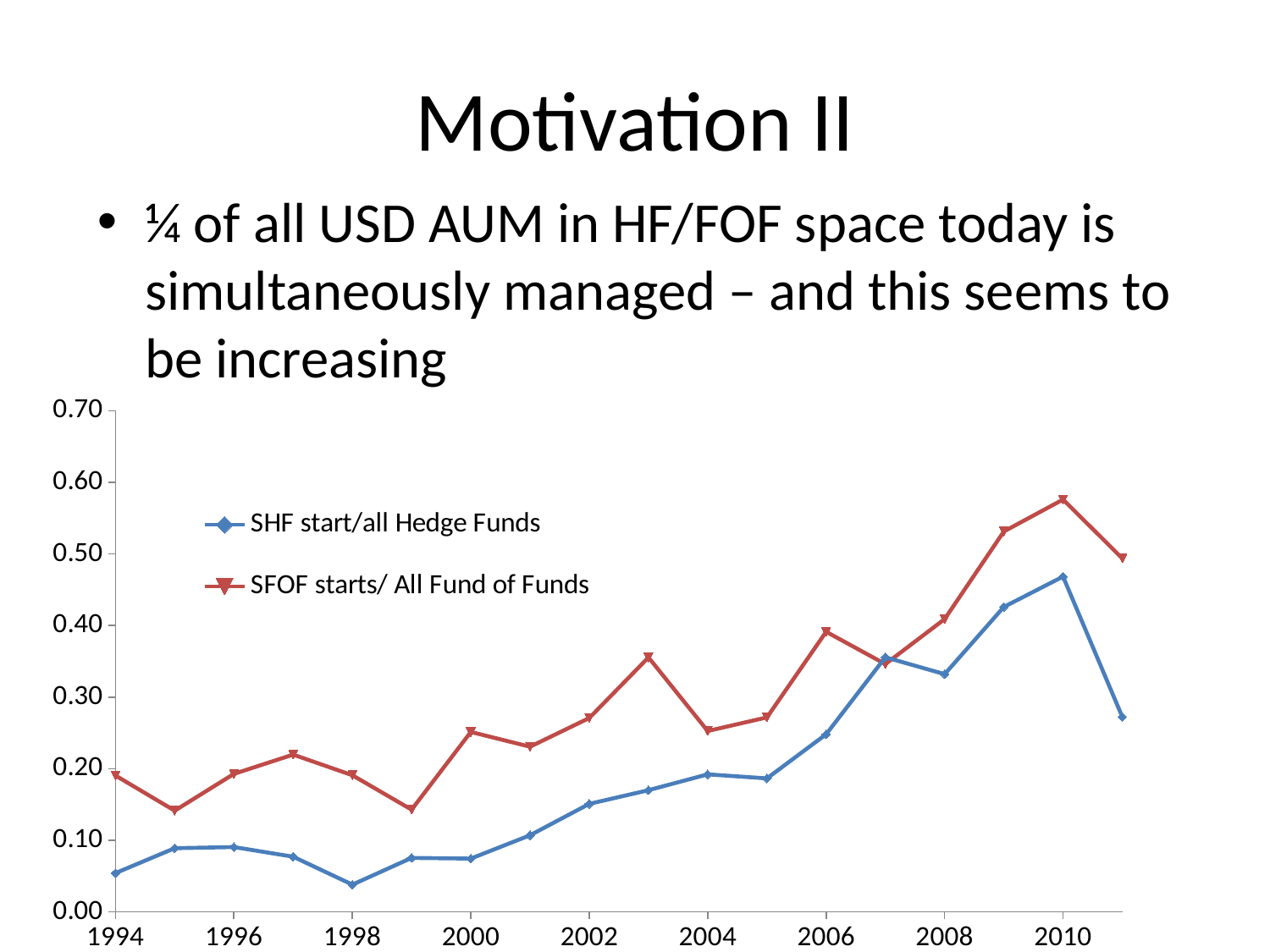
Does the SFOF starts/ All Fund of Funds series rise or fall from 2010 to 2011? fall Is the value for SFOF starts/ All Fund of Funds in 2010 greater or less than 0.50? greater What colour is the line for SFOF starts/ All Fund of Funds? red What are the two series named in the legend? SHF start/all Hedge Funds; SFOF starts/ All Fund of Funds In which year does the SFOF starts/ All Fund of Funds series reach its highest value? 2010 In 2006, which series has the higher value, SHF start/all Hedge Funds or SFOF starts/ All Fund of Funds? SFOF starts/ All Fund of Funds What kind of chart is shown on the slide? line chart Is the value for SHF start/all Hedge Funds in 2011 greater or less than 0.30? less In which year does the SHF start/all Hedge Funds series reach its lowest value? 1998 Is the value for SHF start/all Hedge Funds in 1998 greater or less than 0.10? less In which year does the SHF start/all Hedge Funds series reach its highest value? 2010 How many series does the legend list? 2